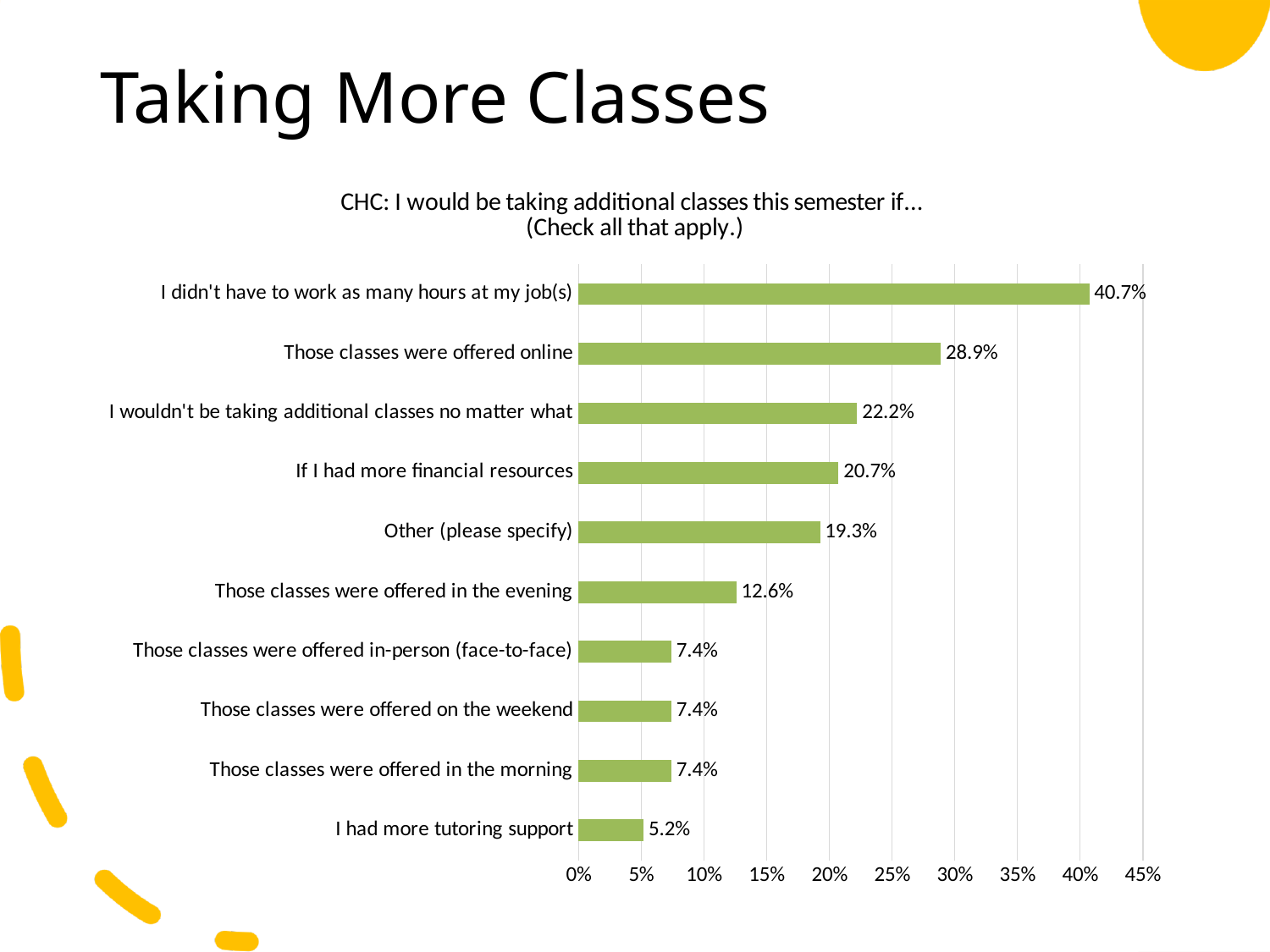
Which category has the highest value? I didn't have to work as many hours at my job(s) Which is larger: 'If I had more financial resources' or 'Other (please specify)'? If I had more financial resources What is the difference between 'I wouldn't be taking additional classes no matter what' and 'If I had more financial resources'? 1.5% Which category has the lowest value? I had more tutoring support What percentage of respondents said they would be taking additional classes if they didn't have to work as many hours at their job(s)? 40.7% How many categories are shown in the chart? 10 What is the title of the chart? CHC: I would be taking additional classes this semester if… (Check all that apply.) What is the difference between 'I didn't have to work as many hours at my job(s)' and 'Those classes were offered online'? 11.8% What type of chart is shown on the slide? Bar chart What is the value for 'Those classes were offered in the evening'? 12.6% What is the value for 'Those classes were offered online'? 28.9% What percentage selected 'I had more tutoring support'? 5.2%